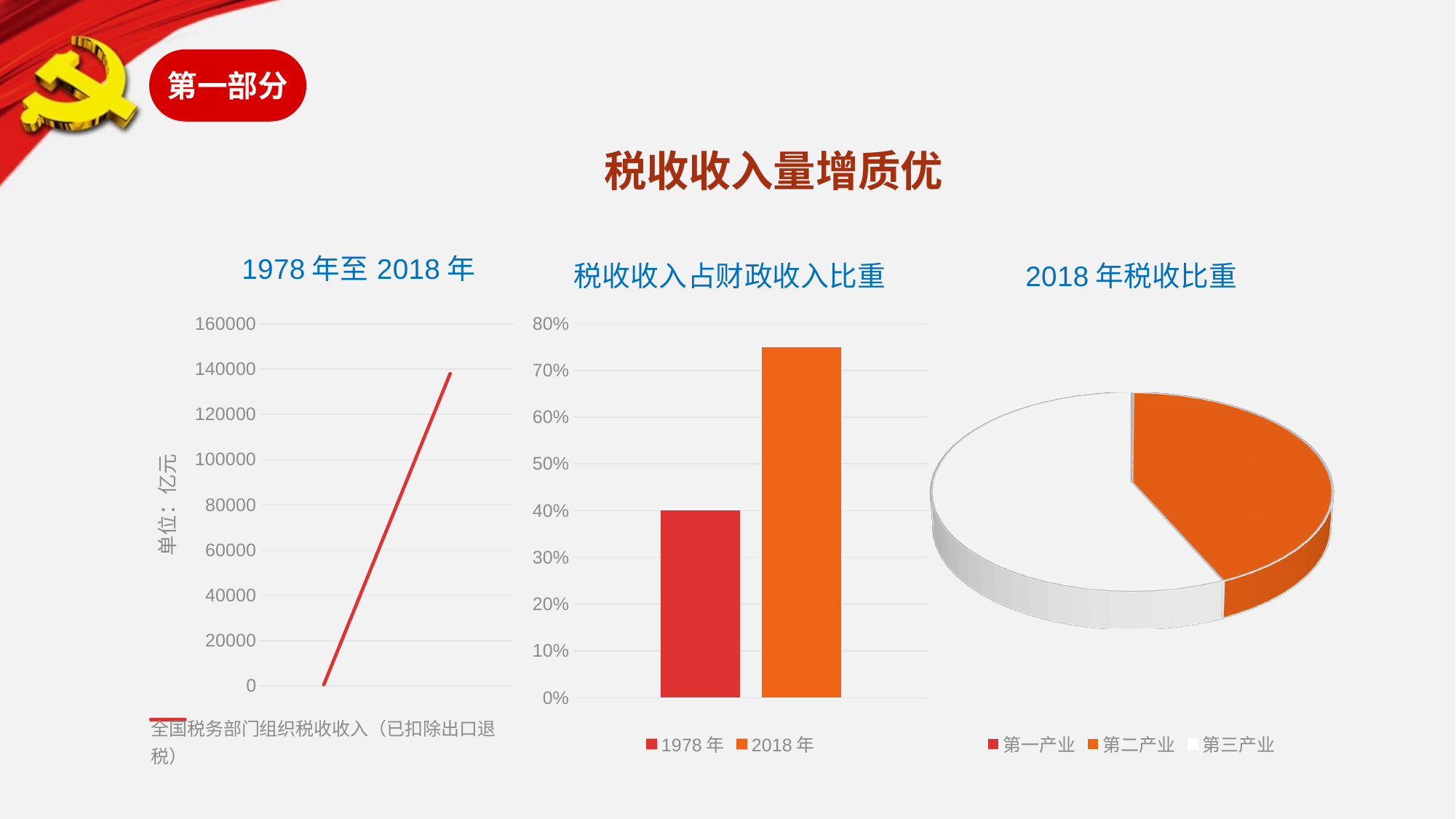
In the chart titled 2018年税收比重, which slice is larger, 第二产业 or 第三产业? 第三产业 What kind of chart is the chart titled 1978年至2018年? line chart In the chart titled 税收收入占财政收入比重, is the value for 1978年 greater or less than 50%? less In the chart titled 2018年税收比重, how many categories does the legend list? 3 In the chart titled 税收收入占财政收入比重, is the value for 2018年 greater or less than 70%? greater In the chart titled 1978年至2018年, is the value at the 2018 end of the line greater or less than 100000? greater What kind of chart is the chart titled 税收收入占财政收入比重? bar chart In the chart titled 1978年至2018年, what unit is shown on the vertical axis label? 亿元 In the chart titled 税收收入占财政收入比重, which year has the higher value, 1978年 or 2018年? 2018年 In the chart titled 税收收入占财政收入比重, how many series does the legend list? 2 What kind of chart is the chart titled 2018年税收比重? pie chart In the chart titled 1978年至2018年, do the values rise or fall from 1978 to 2018? rise